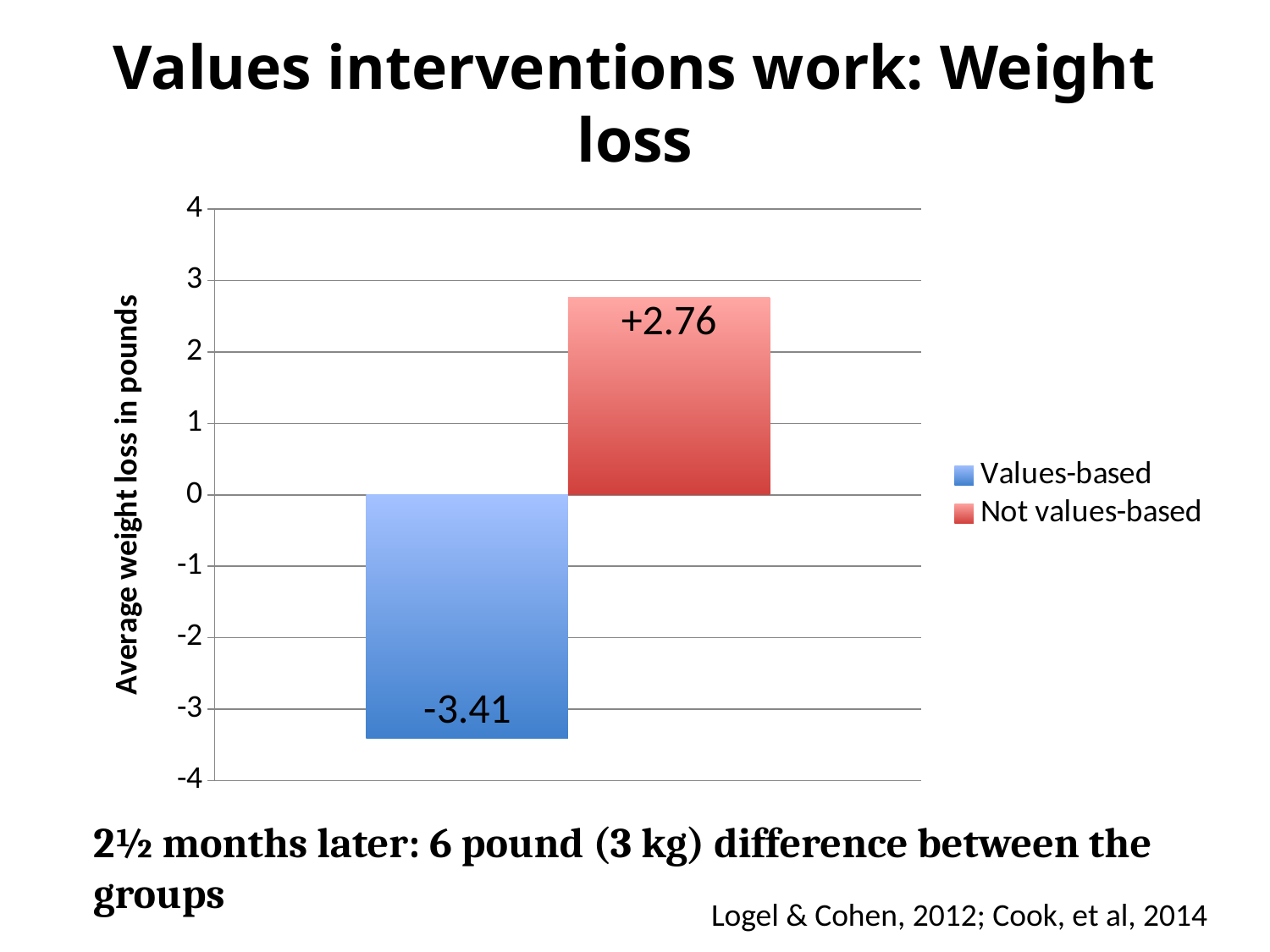
How many series does the legend list? 2 What is the value shown for the Not values-based bar? +2.76 Which series has the lowest value on the chart? Values-based Which series has the higher value on the chart? Not values-based What is the difference between the Not values-based value and the Values-based value? 6.17 What is the value shown for the Values-based bar? -3.41 Is the value for Values-based greater or less than -3? less How many bars are plotted on the chart? 2 What kind of chart is shown on the slide? bar chart Is the value for Not values-based greater or less than 2? greater What is the label on the vertical axis of the chart? Average weight loss in pounds Is the value for Values-based larger or smaller than the value for Not values-based? smaller